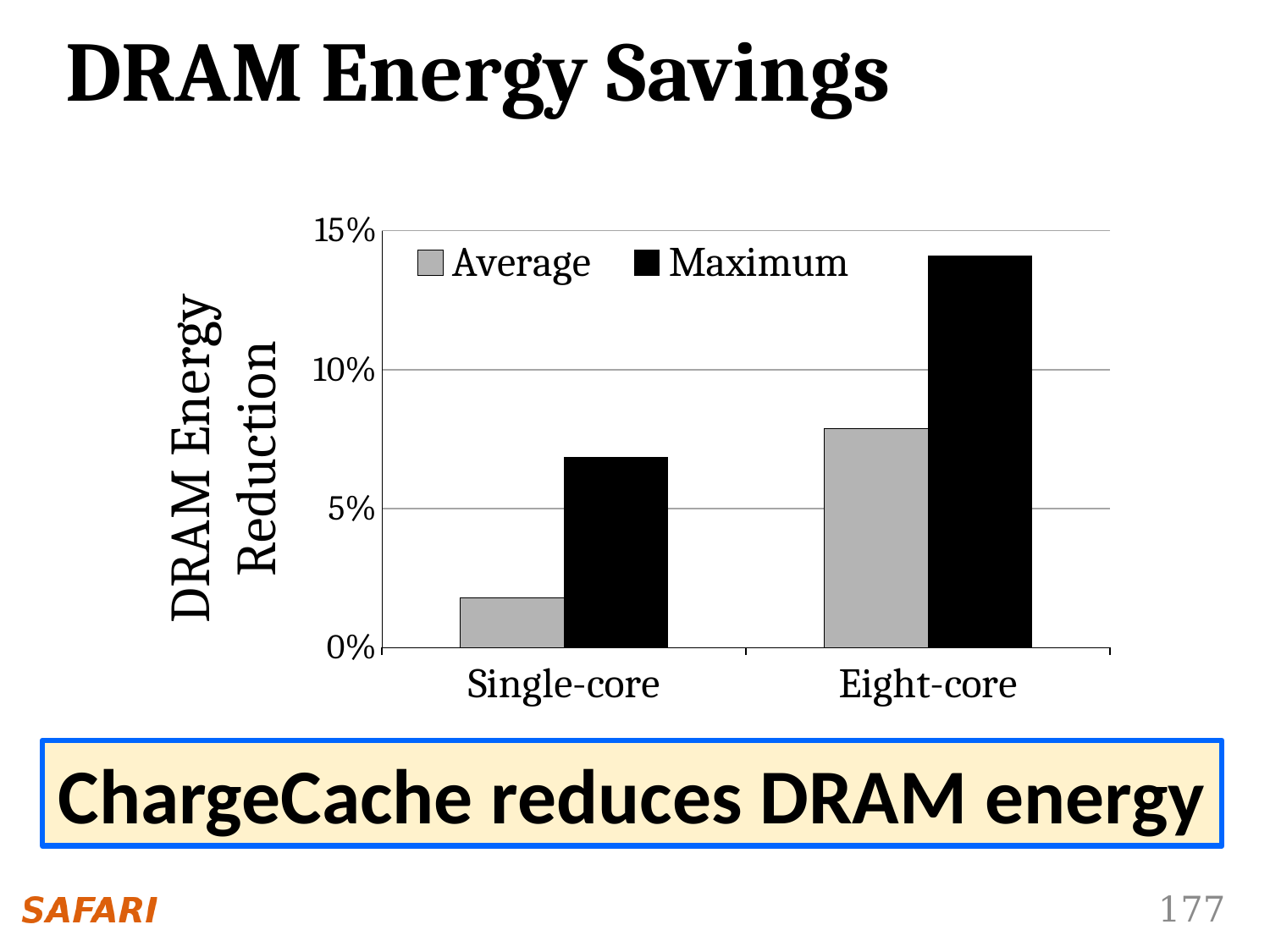
What kind of chart is shown on the slide? bar chart How many categories are shown on the x axis? 2 Which category and series has the tallest bar? Eight-core, Maximum Is the Average value for Eight-core greater or less than 10%? less Is the Maximum value for Eight-core greater or less than 10%? greater How many series does the legend list? 2 What is the label on the y axis? DRAM Energy Reduction Is the Average value for Single-core greater or less than 5%? less Does the Average DRAM energy reduction rise or fall from Single-core to Eight-core? rise Which has the larger Maximum value, Single-core or Eight-core? Eight-core Which category and series has the shortest bar? Single-core, Average